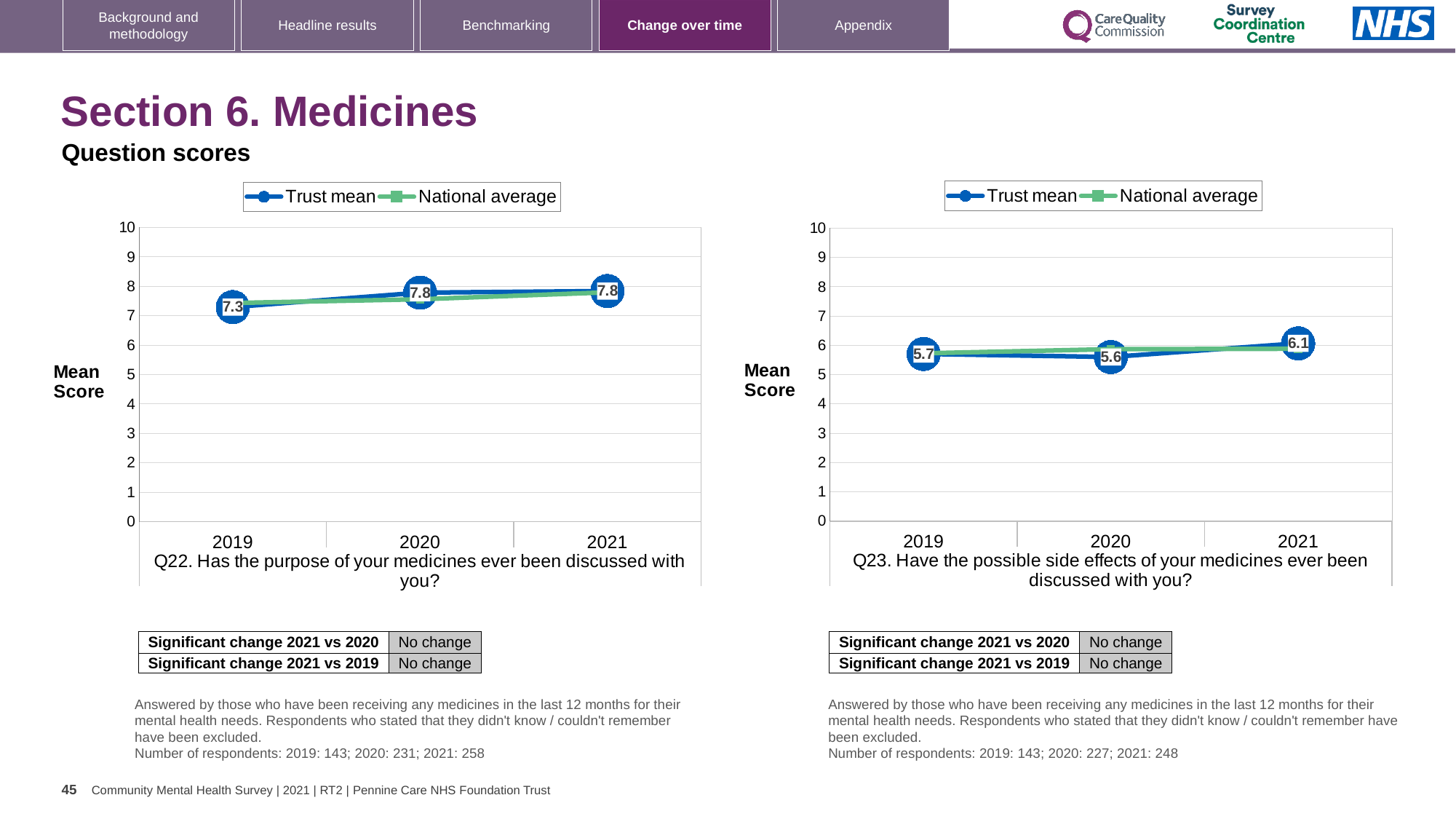
In the Q22 chart (left), is the Trust mean score for 2019 greater or less than 7? greater In the Q22 chart (left), what is the Trust mean score for 2021? 7.8 In the Q23 chart (right), which year has the lowest Trust mean score? 2020 How many years are plotted on the x axis of the Q22 chart (left)? 3 In the Q23 chart (right), what is the Trust mean score for 2021? 6.1 In the Q23 chart (right), what is the Trust mean score for 2020? 5.6 How many series does the legend of the Q22 chart (left) list? 2 In the Q22 chart (left), what is the difference between the Trust mean scores for 2020 and 2019? 0.5 What kind of chart is the Q23 chart (right)? Line chart In the Q22 chart (left), what is the Trust mean score for 2019? 7.3 In the Q23 chart (right), what is the difference between the Trust mean scores for 2021 and 2020? 0.5 In the Q23 chart (right), which year has the highest Trust mean score? 2021